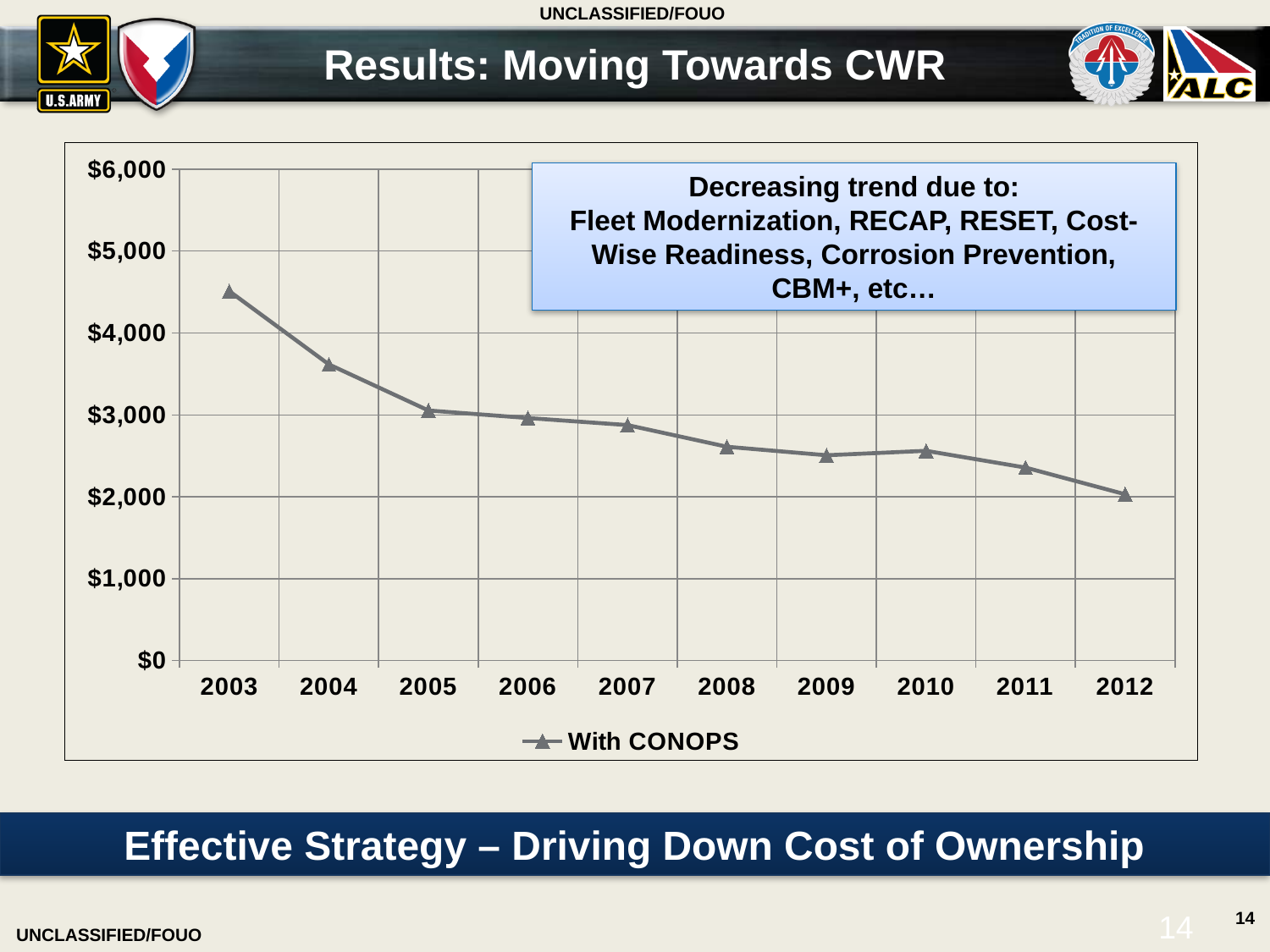
Is the value for 2004 greater or less than $4,000? less What is the name of the series shown in the legend? With CONOPS How many years are plotted along the x axis? 10 Do the With CONOPS values generally rise or fall from 2003 to 2012? Fall What kind of chart is shown on the slide? Line chart Is the value for 2012 greater or less than $1,000? greater Is the value for 2003 greater or less than $4,000? greater Which year has the highest value for With CONOPS? 2003 Which is larger, the value for 2003 or the value for 2004? 2003 Which year has the lowest value for With CONOPS? 2012 How many series does the legend list? 1